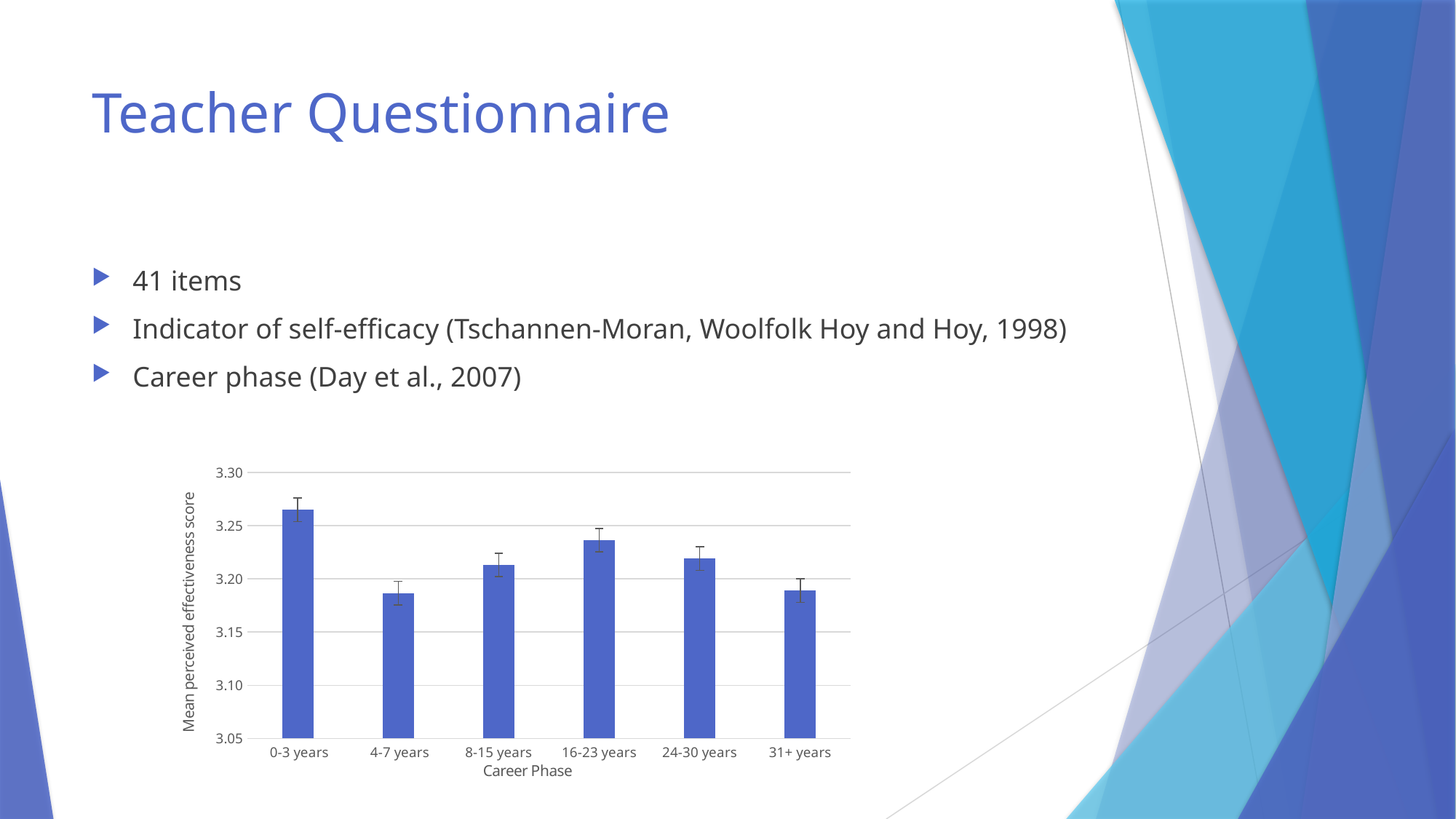
Is the value for 4-7 years greater or less than 3.20? less Is the value for 0-3 years greater or less than 3.25? greater What is the label of the y axis of the chart? Mean perceived effectiveness score Which has a higher mean perceived effectiveness score, 0-3 years or 4-7 years? 0-3 years What is the label of the x axis of the chart? Career Phase What kind of chart is shown on the slide? bar chart Which has a higher mean perceived effectiveness score, 16-23 years or 31+ years? 16-23 years Which career phase has the highest mean perceived effectiveness score? 0-3 years Is the value for 24-30 years greater or less than 3.25? less How many career phase categories are shown on the x axis of the chart? 6